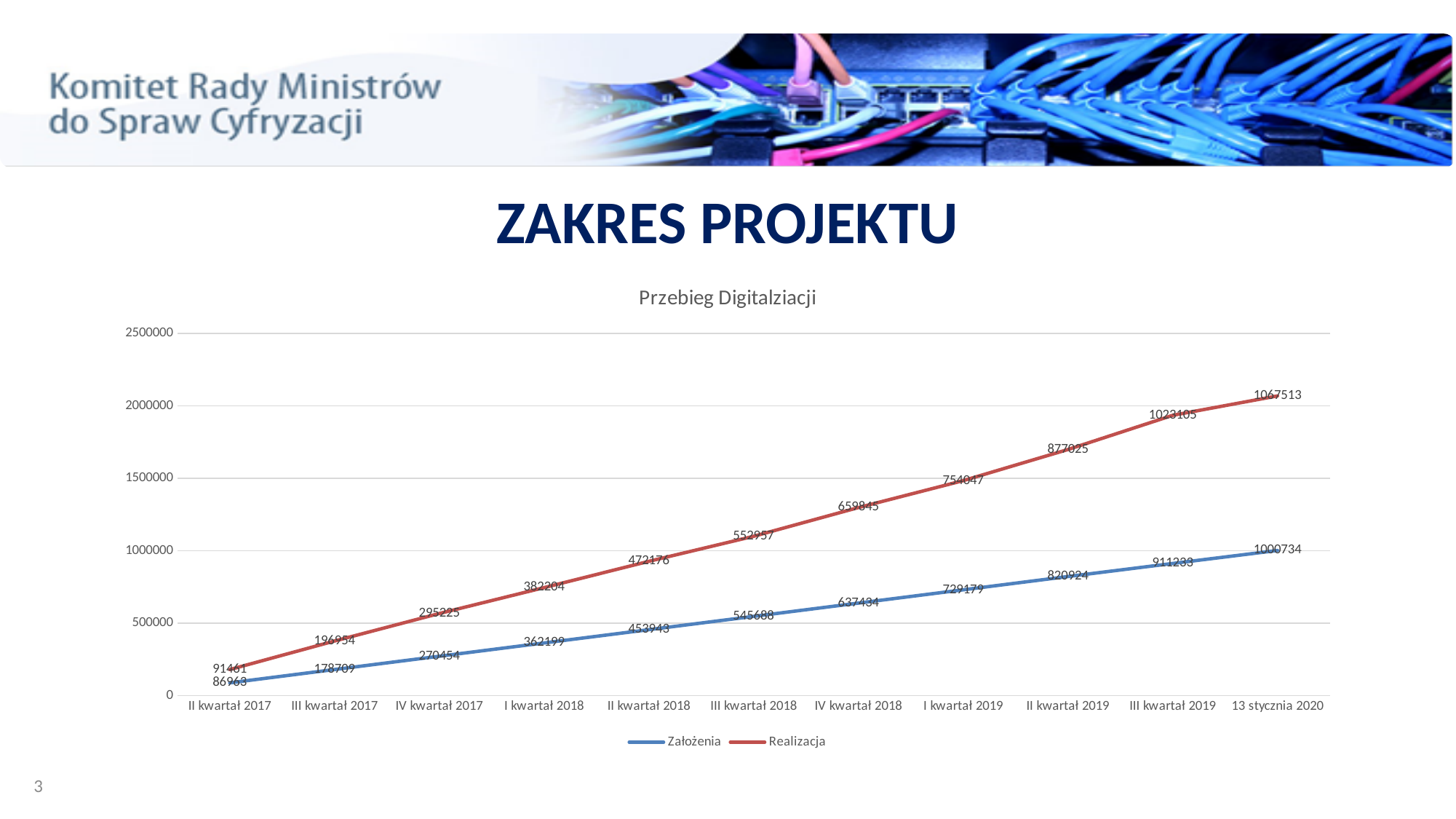
Does the Realizacja series rise or fall along the x axis? rise What is the difference between Realizacja and Założenia at 13 stycznia 2020? 66779 What is the value of Realizacja at II kwartał 2017? 91461 What is the value of Realizacja at 13 stycznia 2020? 1067513 At 13 stycznia 2020, which series has the higher value, Założenia or Realizacja? Realizacja What type of chart is shown on the slide? line chart What is the title of the chart? Przebieg Digitalziacji What is the value of Założenia at 13 stycznia 2020? 1000734 What is the value of Założenia at II kwartał 2017? 86963 How many categories are shown on the x axis? 11 How many series does the legend list? 2 What is the value of Realizacja at III kwartał 2019? 1023105